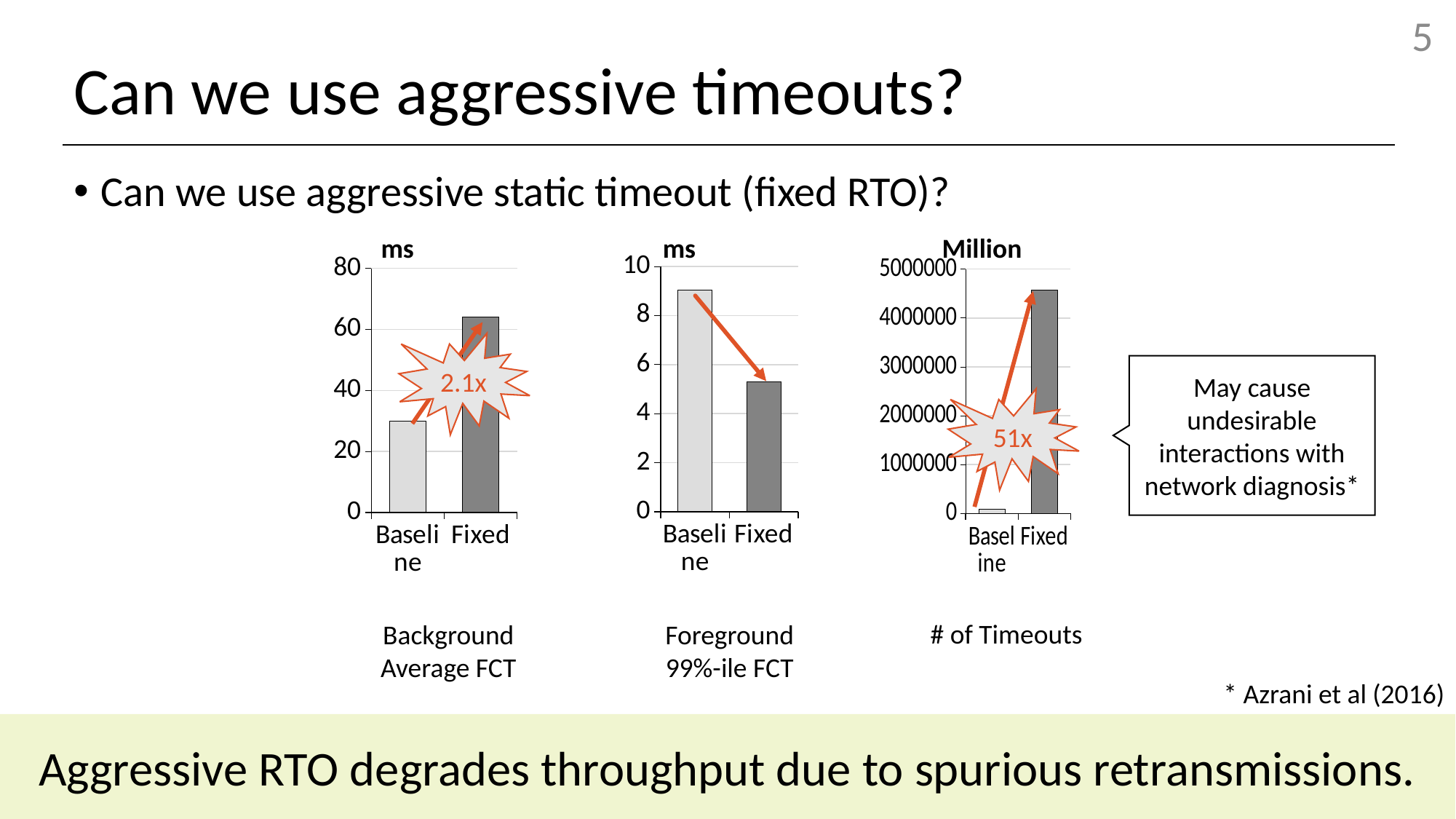
What multiplier is shown in the starburst annotation on the # of Timeouts chart? 51x In the Foreground 99%-ile FCT chart, is the value for Baseline greater or less than 8? greater In the # of Timeouts chart, is the value for Baseline greater or less than 1000000? less What kind of chart is the Background Average FCT chart? bar chart In the Foreground 99%-ile FCT chart, is the value for Fixed greater or less than 6? less In the Background Average FCT chart, how many categories are shown on the x axis? 2 In the Background Average FCT chart, which category has the higher value, Baseline or Fixed? Fixed In the Foreground 99%-ile FCT chart, which category has the lowest value? Fixed In the # of Timeouts chart, which category has the highest value? Fixed